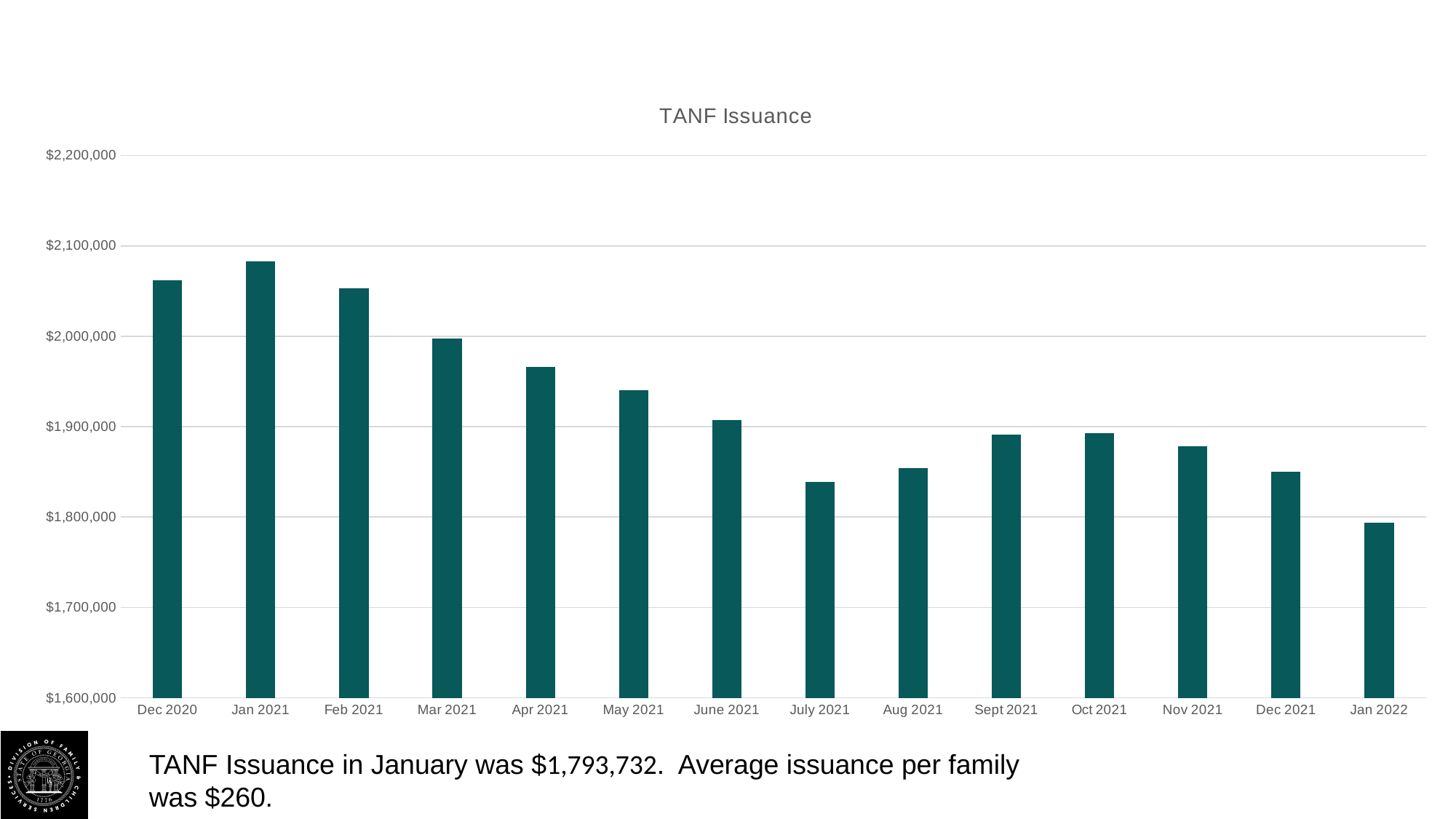
What kind of chart is shown on the slide? Bar chart Which is larger, the value for May 2021 or June 2021? May 2021 Is the value for Dec 2020 greater or less than $2,000,000? greater What is the title of the chart? TANF Issuance Which is larger, the value for July 2021 or Aug 2021? Aug 2021 Is the value for Apr 2021 greater or less than $2,000,000? less Which month has the lowest TANF issuance? Jan 2022 What was the TANF issuance for Jan 2022? $1,793,732 How many months are plotted in the TANF Issuance chart? 14 Which month has the highest TANF issuance? Jan 2021 Is the value for July 2021 greater or less than $1,800,000? greater Do TANF issuance values generally rise or fall from Dec 2020 to Jan 2022? Fall